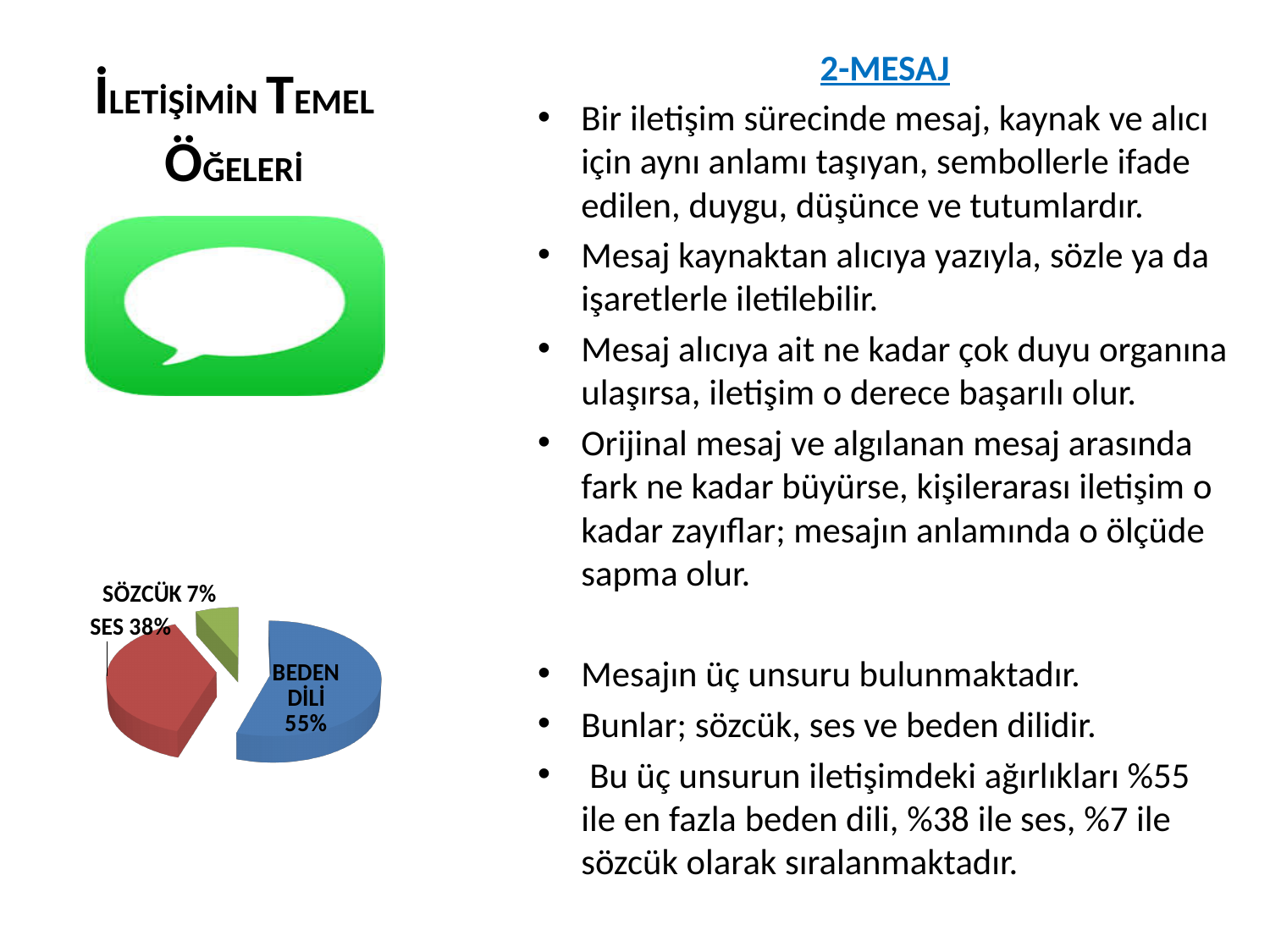
What is the difference between the BEDEN DİLİ and SES values in the pie chart? 17% What is the value shown for SES in the pie chart? 38% Which slice of the pie chart is the largest? BEDEN DİLİ Which is larger in the pie chart, SES or SÖZCÜK? SES Which slice of the pie chart is the smallest? SÖZCÜK What is the value shown for SÖZCÜK in the pie chart? 7% What share of the pie does the SES slice represent? 38% What is the value shown for BEDEN DİLİ in the pie chart? 55% What is the difference between the SES and SÖZCÜK values in the pie chart? 31% What colour is the BEDEN DİLİ slice in the pie chart? blue What kind of chart is shown on the slide? pie chart How many slices does the pie chart have? 3